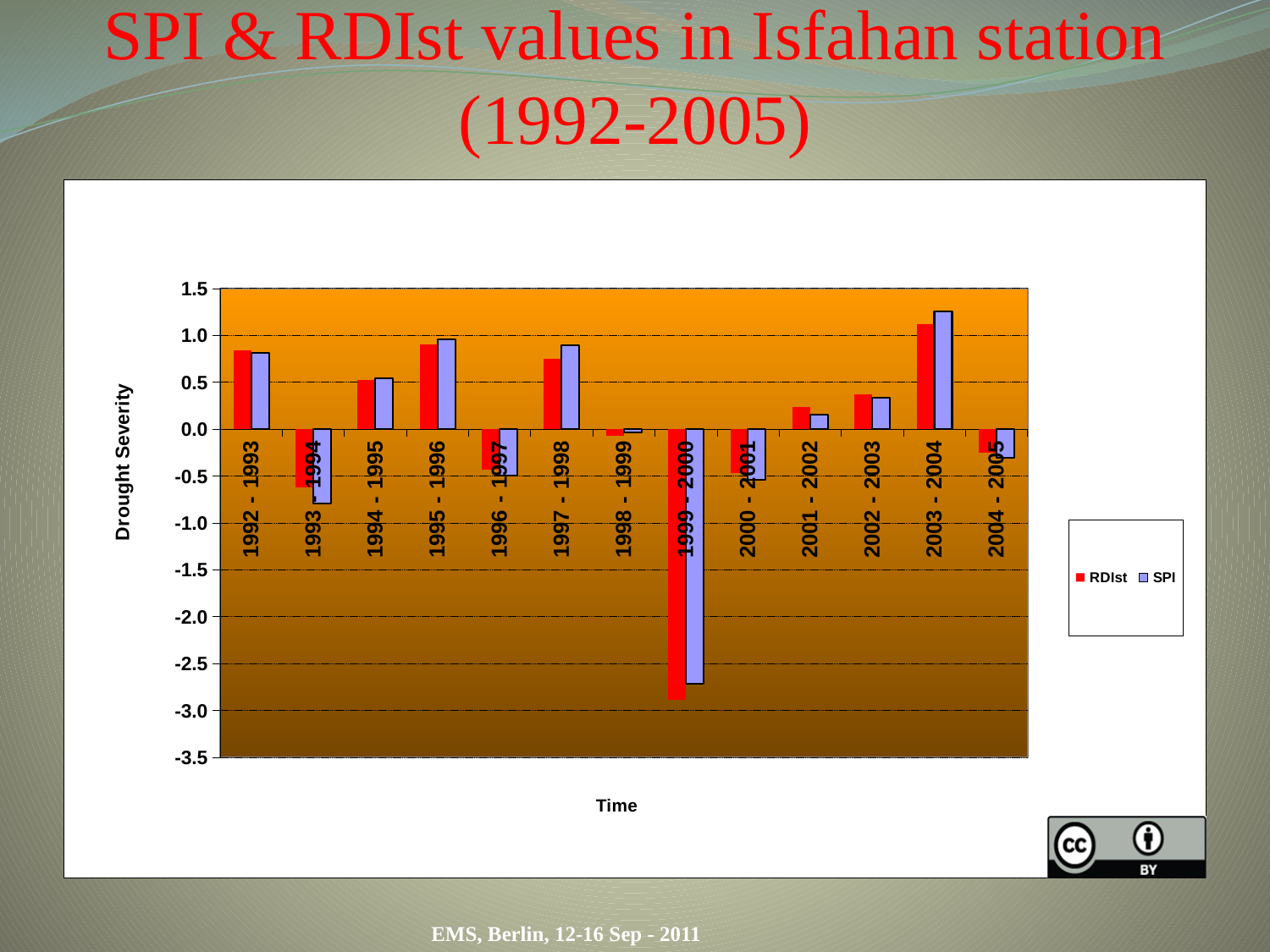
What is the label of the vertical axis? Drought Severity For 2003 - 2004, which series has the larger value, RDIst or SPI? SPI Is the RDIst value for 1999 - 2000 greater or less than -2.5? less Which is larger, the RDIst value for 1992 - 1993 or the RDIst value for 2003 - 2004? 2003 - 2004 How many series does the legend list? 2 How many time periods are shown on the x axis? 13 Is the SPI value for 2003 - 2004 greater or less than 1.0? greater Is the SPI value for 1993 - 1994 greater or less than -0.5? less Which time period has the lowest RDIst value? 1999 - 2000 What kind of chart is shown on the slide? bar chart Which time period has the highest SPI value? 2003 - 2004